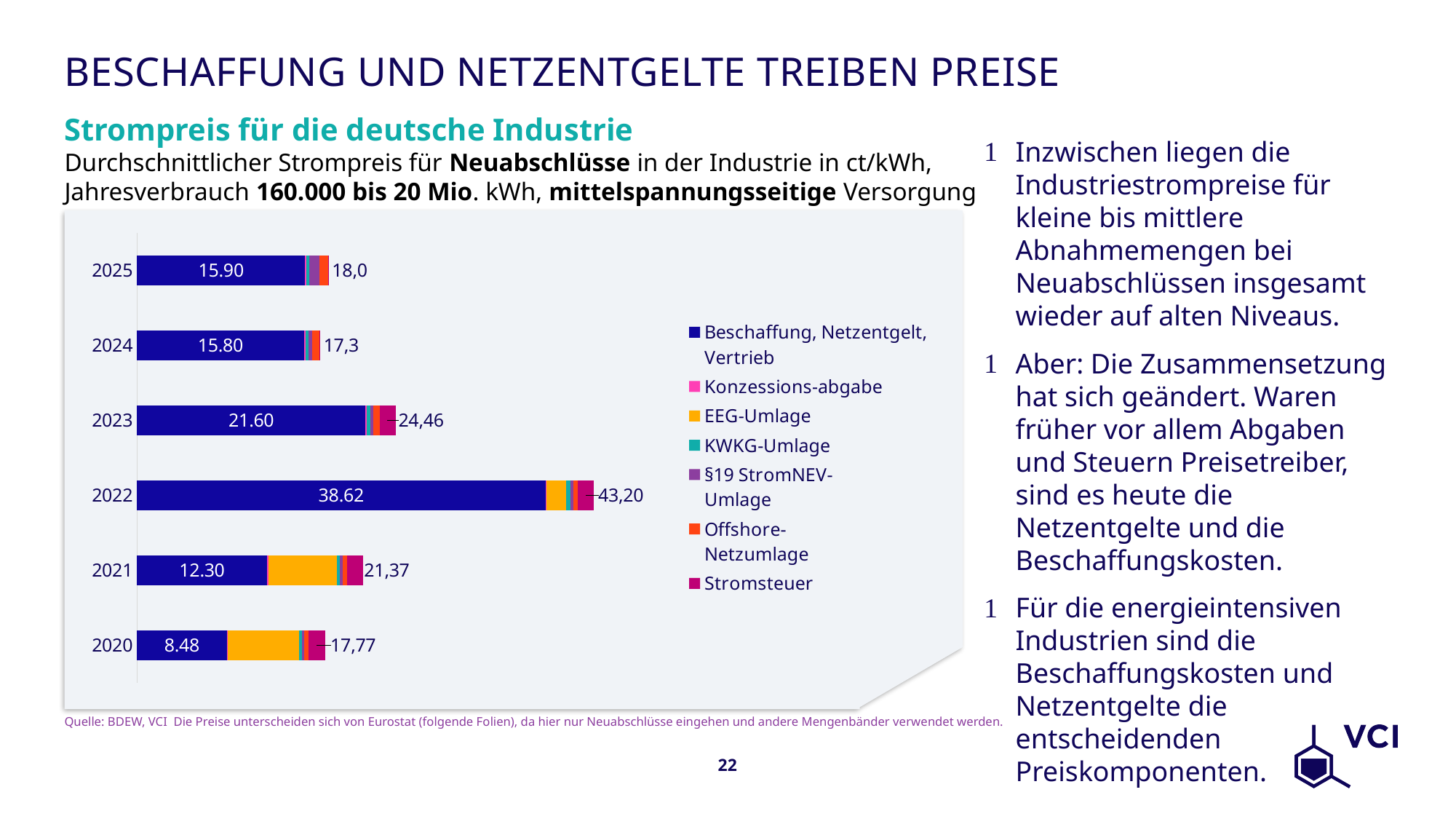
Which year has the lowest value for the Beschaffung, Netzentgelt, Vertrieb segment? 2020 How many years are shown in the chart? 6 What is the value of the Beschaffung, Netzentgelt, Vertrieb segment for 2022? 38.62 What kind of chart is shown on the slide? Stacked bar chart How many series does the legend list? 7 What is the value of the Beschaffung, Netzentgelt, Vertrieb segment for 2020? 8.48 What is the total electricity price shown for 2023? 24,46 What is the total electricity price shown for 2025? 18,0 What is the title of the chart? Strompreis für die deutsche Industrie What is the difference between the Beschaffung, Netzentgelt, Vertrieb values for 2022 and 2020? 30.14 Which year has the highest total electricity price? 2022 Is the total price for 2021 larger or smaller than the total price for 2024? larger